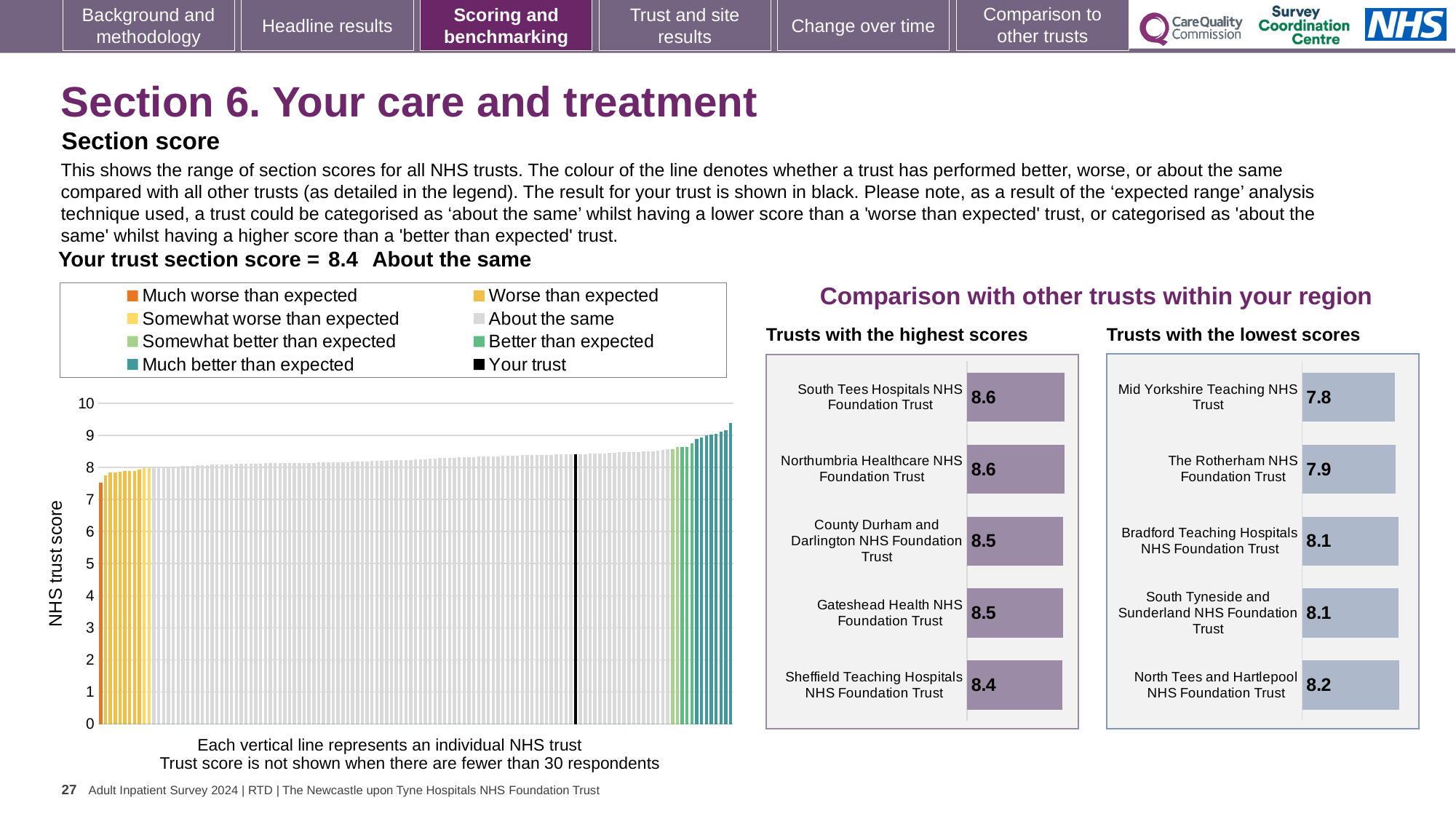
In the 'Trusts with the highest scores' chart, what is the score for South Tees Hospitals NHS Foundation Trust? 8.6 In the 'Trusts with the highest scores' chart, what is the score for Gateshead Health NHS Foundation Trust? 8.5 In the 'Trusts with the lowest scores' chart, which has the higher score: The Rotherham NHS Foundation Trust or Bradford Teaching Hospitals NHS Foundation Trust? Bradford Teaching Hospitals NHS Foundation Trust How many trusts are listed in the 'Trusts with the lowest scores' chart? 5 In the 'Trusts with the highest scores' chart, which trust has the lowest score shown? Sheffield Teaching Hospitals NHS Foundation Trust In the main chart on the left showing all NHS trusts, is the value of the rightmost (highest) bar greater or less than 9? greater In the 'Trusts with the lowest scores' chart, what is the score for The Rotherham NHS Foundation Trust? 7.9 How many entries does the legend of the main chart on the left list? 8 In the 'Trusts with the lowest scores' chart, what is the difference between the scores of North Tees and Hartlepool NHS Foundation Trust and Mid Yorkshire Teaching NHS Trust? 0.4 In the 'Trusts with the lowest scores' chart, which trust has the lowest score? Mid Yorkshire Teaching NHS Trust In the main chart on the left showing all NHS trusts, do the values rise or fall from left to right? rise In the 'Trusts with the highest scores' chart, what is the difference between the scores of South Tees Hospitals NHS Foundation Trust and Sheffield Teaching Hospitals NHS Foundation Trust? 0.2